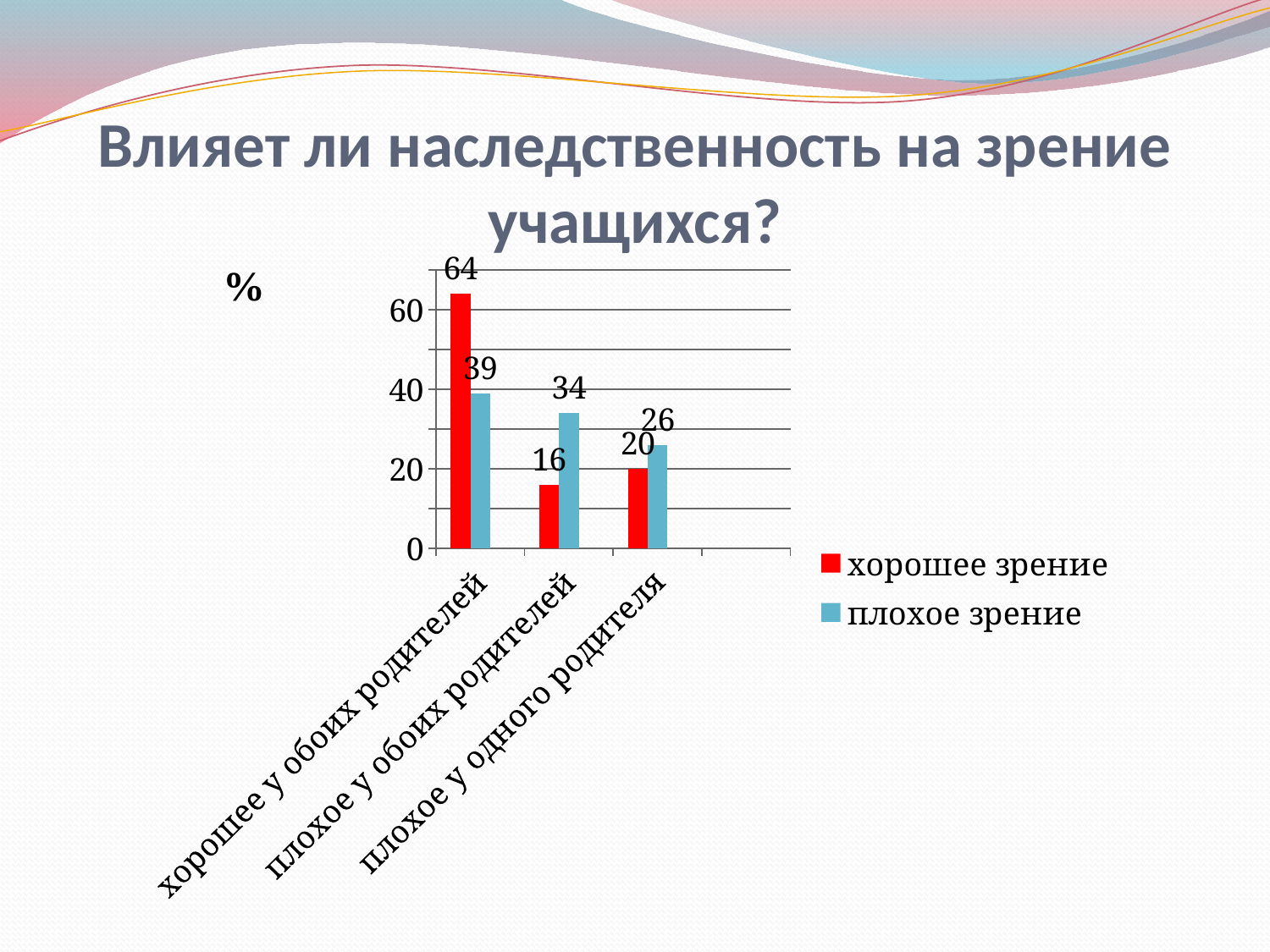
What is the difference between 'хорошее зрение' and 'плохое зрение' in the category 'хорошее у обоих родителей'? 25 How many categories are shown on the x axis? 3 In the category 'плохое у одного родителя', which is larger: 'хорошее зрение' or 'плохое зрение'? плохое зрение What is the value for 'хорошее зрение' in the category 'хорошее у обоих родителей'? 64 How many series does the legend list? 2 What kind of chart is shown on the slide? bar chart Which colour represents 'плохое зрение' in the legend? blue Which category has the highest value for 'хорошее зрение'? хорошее у обоих родителей What is the value for 'плохое зрение' in the category 'плохое у обоих родителей'? 34 What is the value for 'хорошее зрение' in the category 'плохое у одного родителя'? 20 Which category has the lowest value for 'хорошее зрение'? плохое у обоих родителей What is the value for 'плохое зрение' in the category 'хорошее у обоих родителей'? 39